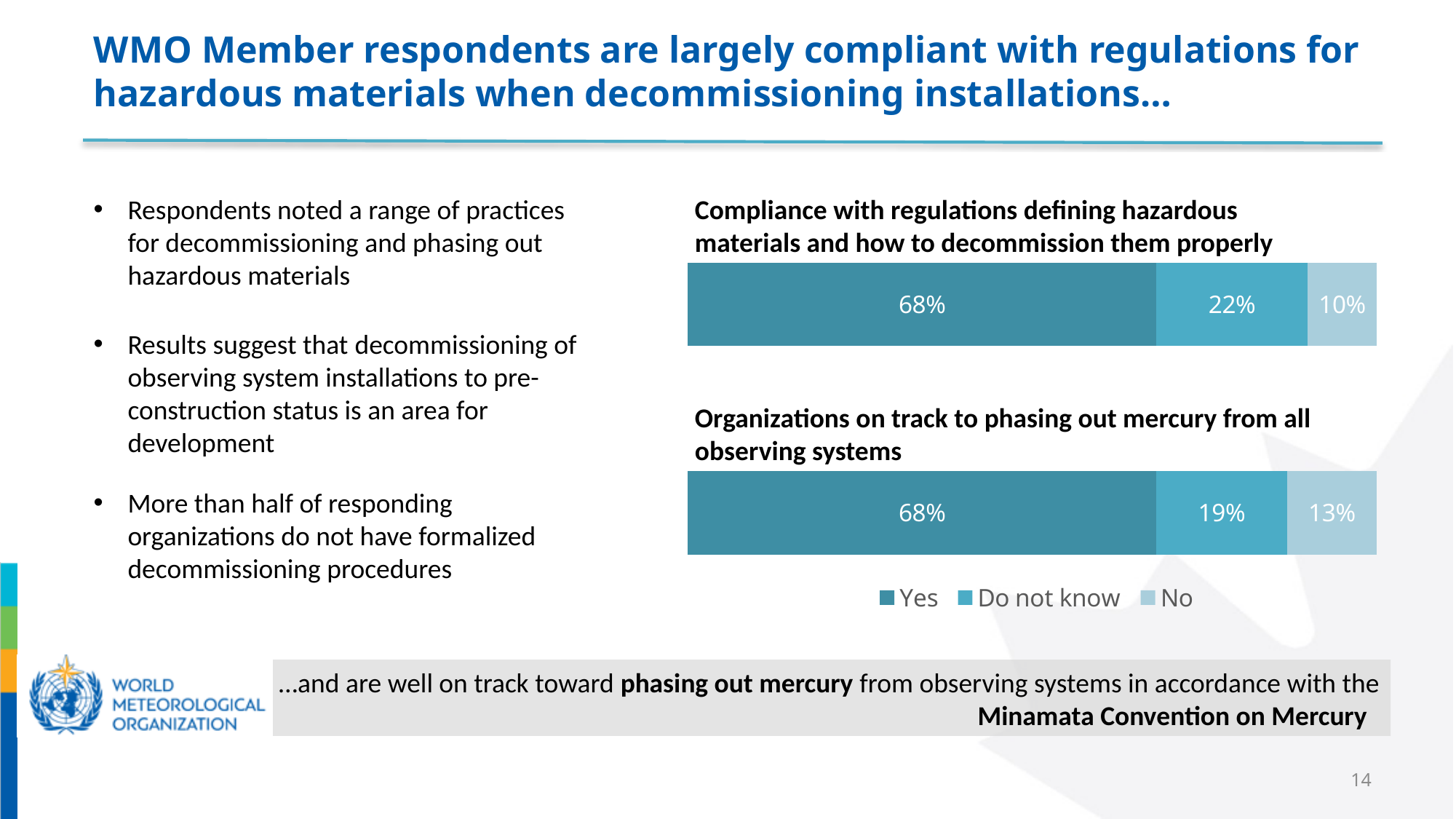
In the 'Compliance with regulations defining hazardous materials' chart, what is the difference between the Yes and Do not know percentages? 46% What are the three legend entries shown below the charts? Yes, Do not know, No In the 'Compliance with regulations defining hazardous materials and how to decommission them properly' chart, what percentage answered Yes? 68% What type of chart is used to show the 'Organizations on track to phasing out mercury from all observing systems' data? Stacked bar chart Which chart has the larger No percentage: the 'Compliance with regulations' chart or the 'Organizations on track to phasing out mercury' chart? Organizations on track to phasing out mercury In the 'Compliance with regulations defining hazardous materials and how to decommission them properly' chart, what percentage answered No? 10% In the 'Organizations on track to phasing out mercury from all observing systems' chart, what percentage answered Do not know? 19% In the 'Compliance with regulations defining hazardous materials and how to decommission them properly' chart, what percentage answered Do not know? 22% In the 'Organizations on track to phasing out mercury from all observing systems' chart, what percentage answered No? 13% In the 'Organizations on track to phasing out mercury' chart, which response has the smallest share? No In the 'Compliance with regulations defining hazardous materials' chart, which response has the largest share? Yes How many series does the legend list for the charts on the slide? 3